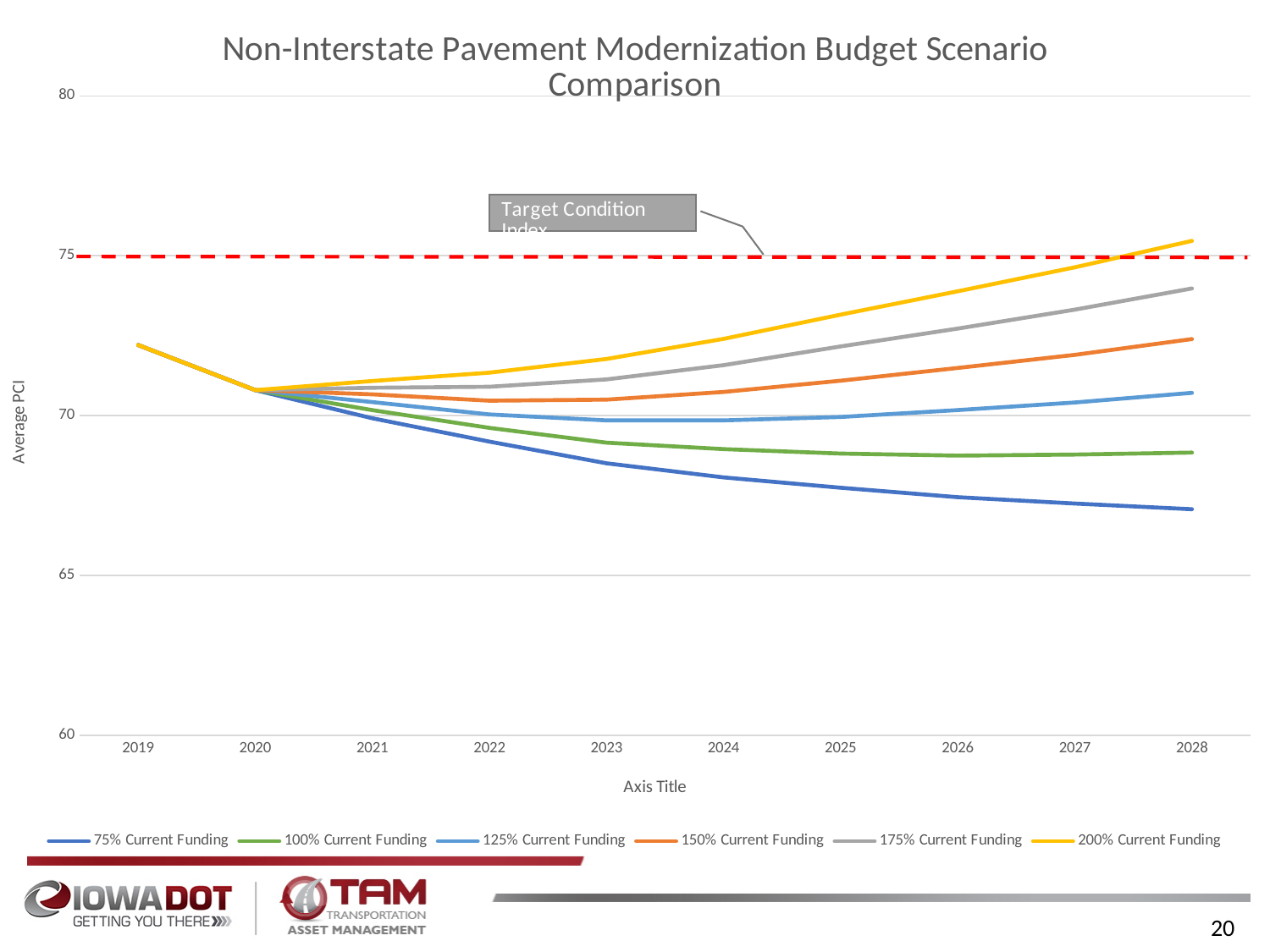
Is the value for 200% Current Funding in 2028 greater or less than 75? greater Does the 75% Current Funding line rise or fall from 2019 to 2028? fall Which funding scenario has the highest Average PCI in 2028? 200% Current Funding What kind of chart is shown on the slide? line chart What does the red dashed horizontal line represent? Target Condition Index In 2028, which is larger: the value for 150% Current Funding or 125% Current Funding? 150% Current Funding Is the value for 75% Current Funding in 2028 greater or less than 70? less Which funding scenario has the lowest Average PCI in 2028? 75% Current Funding How many years are shown along the x axis? 10 Does the 200% Current Funding line rise or fall from 2020 to 2028? rise How many series does the legend list? 6 Is the value for 175% Current Funding in 2028 greater or less than 75? less